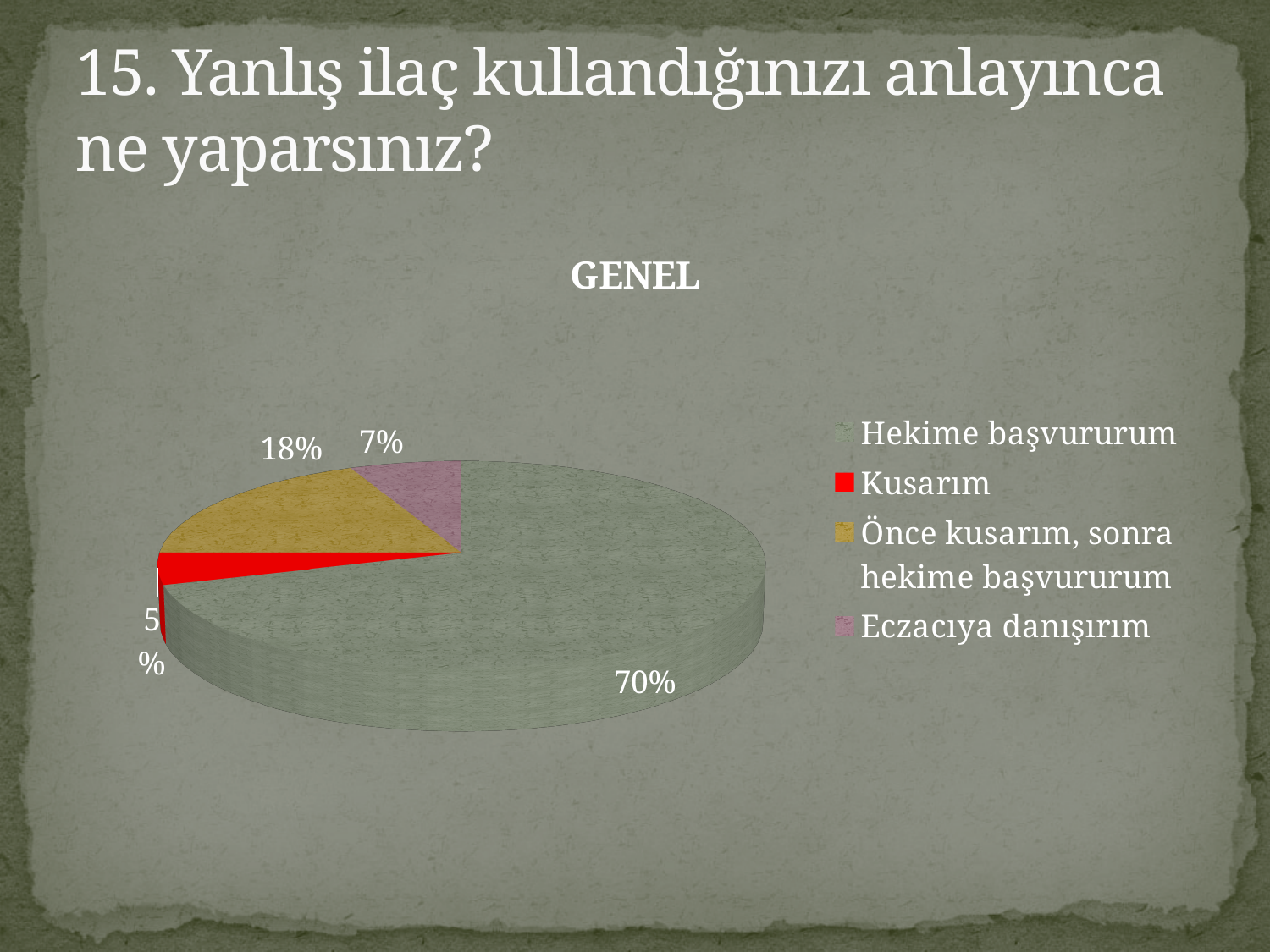
What percentage of the pie is 'Önce kusarım, sonra hekime başvururum'? 18% Which is larger, the share for 'Eczacıya danışırım' or the share for 'Kusarım'? Eczacıya danışırım Which category has the smallest share of the pie? Kusarım Which category has the largest share of the pie? Hekime başvururum What kind of chart is shown on the slide? pie chart What is the title of the chart? GENEL What percentage of the pie is 'Hekime başvururum'? 70% What is the difference between the shares of 'Hekime başvururum' and 'Önce kusarım, sonra hekime başvururum'? 52% What percentage of the pie is 'Eczacıya danışırım'? 7% How many categories does the legend list? 4 What colour is the 'Kusarım' slice? red What percentage of the pie is 'Kusarım'? 5%